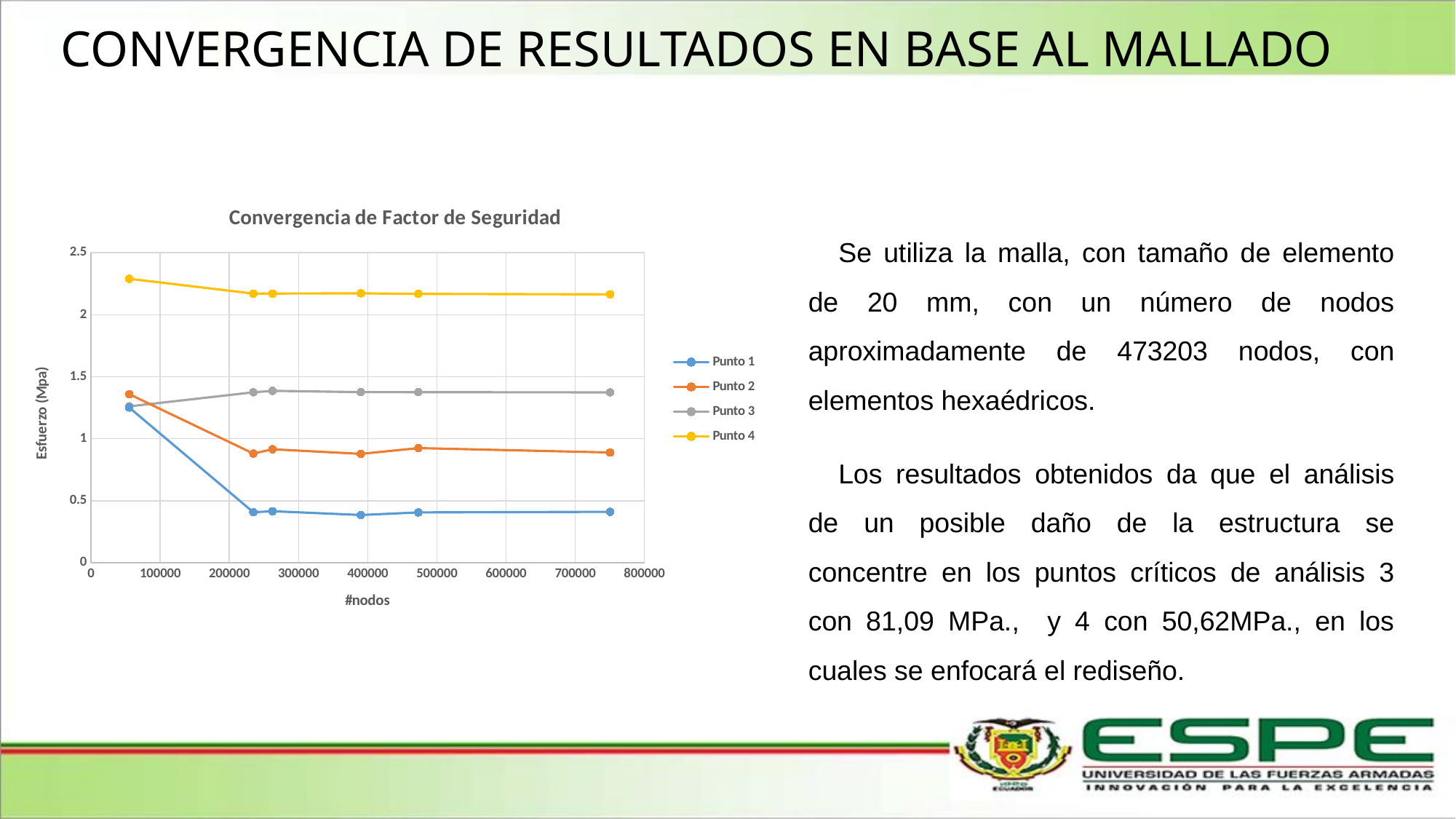
Is the value for Punto 1 at about 750000 nodes greater or less than 0.5? less Which series has the highest values across the chart? Punto 4 Which series has the larger value at about 750000 nodes, Punto 2 or Punto 3? Punto 3 Is the value for Punto 3 at about 750000 nodes greater or less than 1? greater Which series has the lowest values at the right end of the chart? Punto 1 Does the Punto 1 series rise or fall between its first and second points along the x axis? fall Is the value for Punto 4 at about 750000 nodes greater or less than 2? greater What is the label of the y axis of the chart? Esfuerzo (Mpa) How many series does the legend of the chart list? 4 What kind of chart is shown on the slide? line chart How many data points are plotted for each series in the chart? 6 What is the title of the chart? Convergencia de Factor de Seguridad